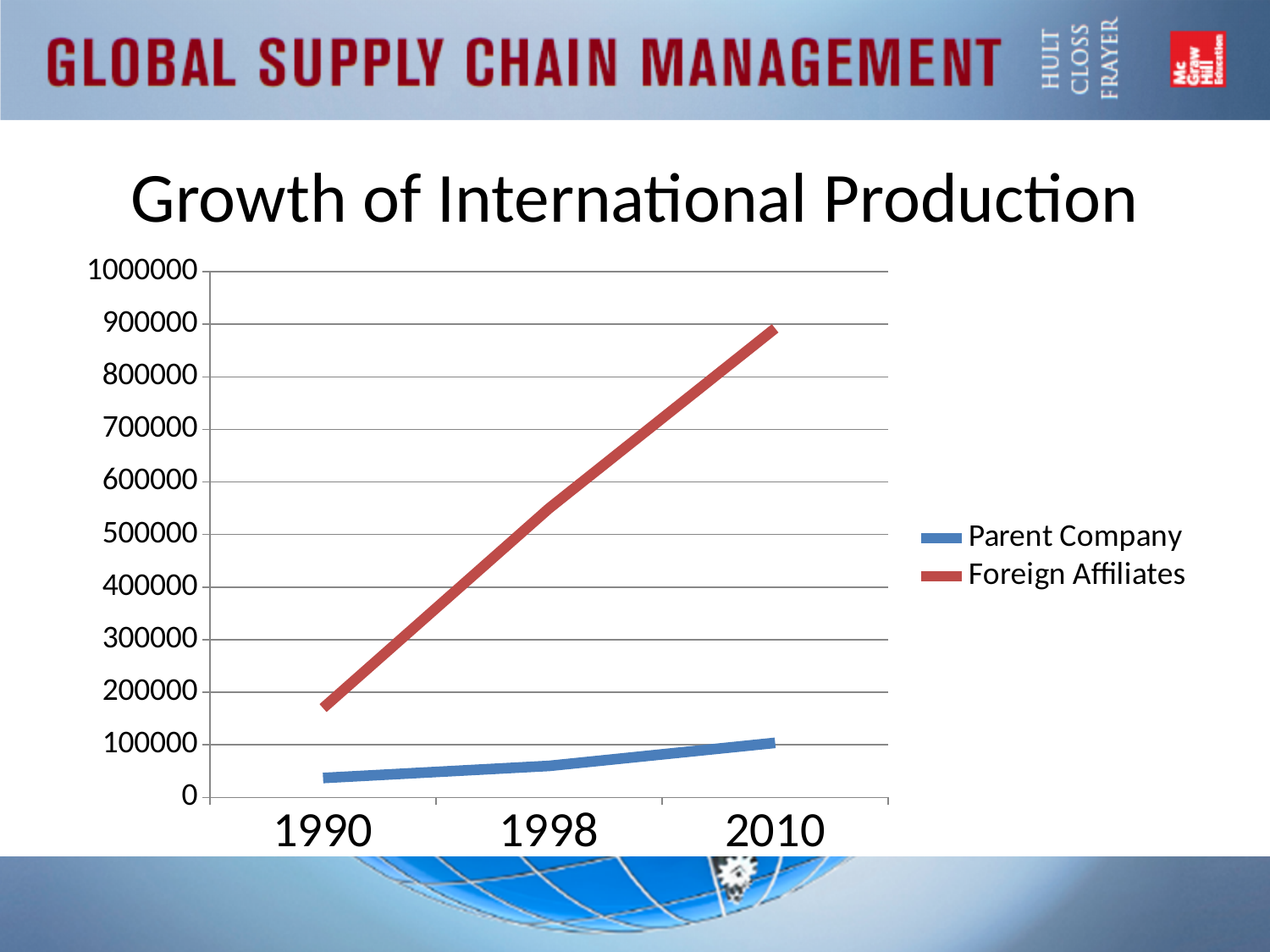
Is the value for Parent Company in 1998 greater or less than 100000? less In which year is the value for Foreign Affiliates lowest? 1990 How many years are shown on the x axis? 3 What kind of chart is shown on the slide? line chart What is the title of the chart? Growth of International Production Which series is drawn in red? Foreign Affiliates In 2010, which series has the larger value, Parent Company or Foreign Affiliates? Foreign Affiliates Is the value for Foreign Affiliates in 1998 greater or less than 500000? greater Is the value for Foreign Affiliates in 2010 greater or less than 800000? greater How many series does the legend list? 2 Do the values for Foreign Affiliates rise or fall from 1990 to 2010? rise